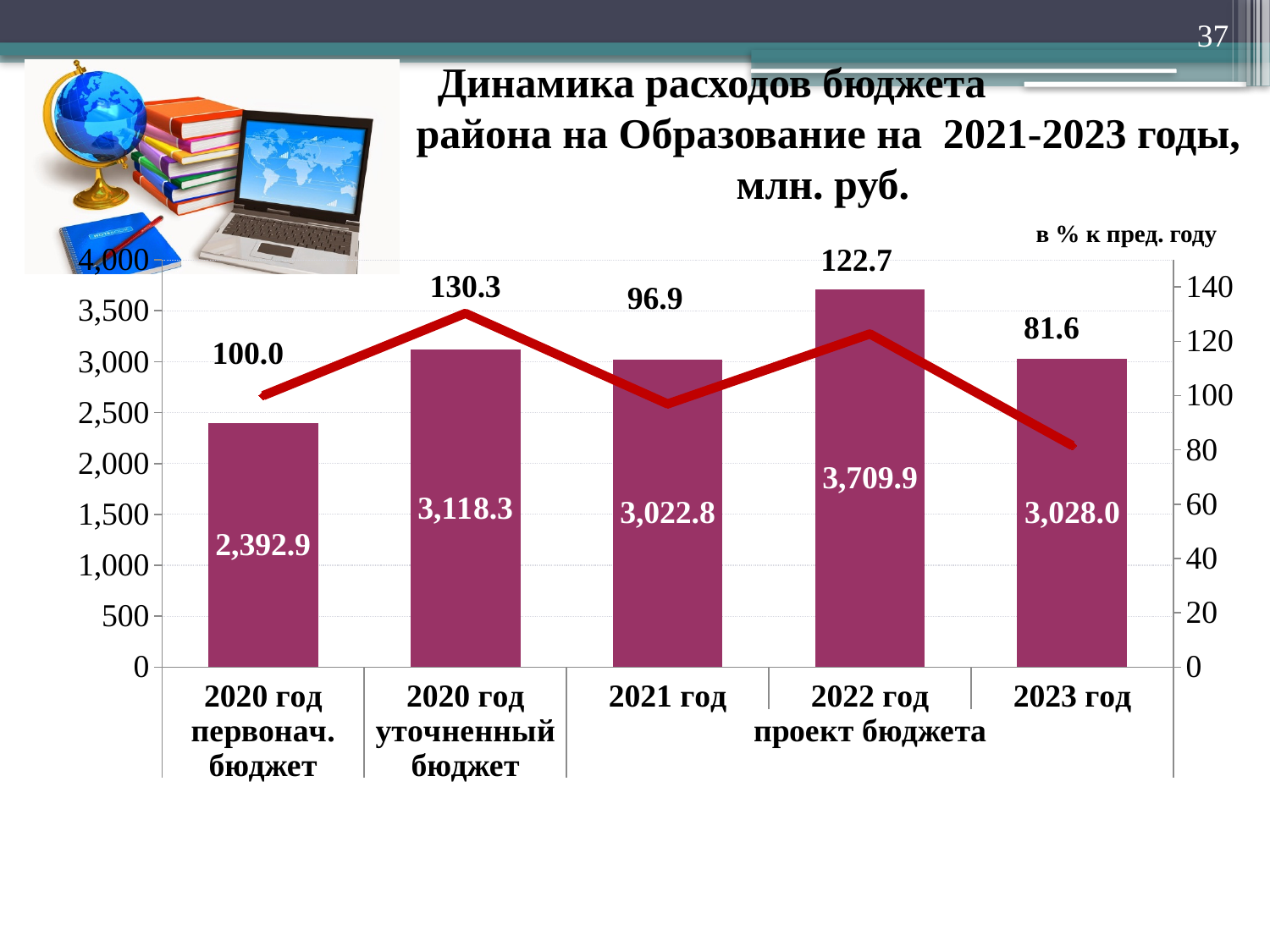
How many categories are shown on the x axis? 5 Which category has the lowest bar value? 2020 год первонач. бюджет What percentage to the previous year is shown for 2023 год? 81.6 What is the budget expenditure value shown for 2022 год? 3,709.9 Which category has the highest bar value? 2022 год What percentage to the previous year is shown for 2020 год уточненный бюджет? 130.3 Which is larger, the bar value for 2020 год уточненный бюджет or for 2023 год? 2020 год уточненный бюджет What is the difference between the bar values for 2022 год and 2021 год? 687.1 What is the bar value for 2020 год первонач. бюджет? 2,392.9 What kind of chart is this? Combined bar and line chart What is the label shown above the right-hand axis? в % к пред. году Which category has the lowest percentage to the previous year on the line? 2023 год